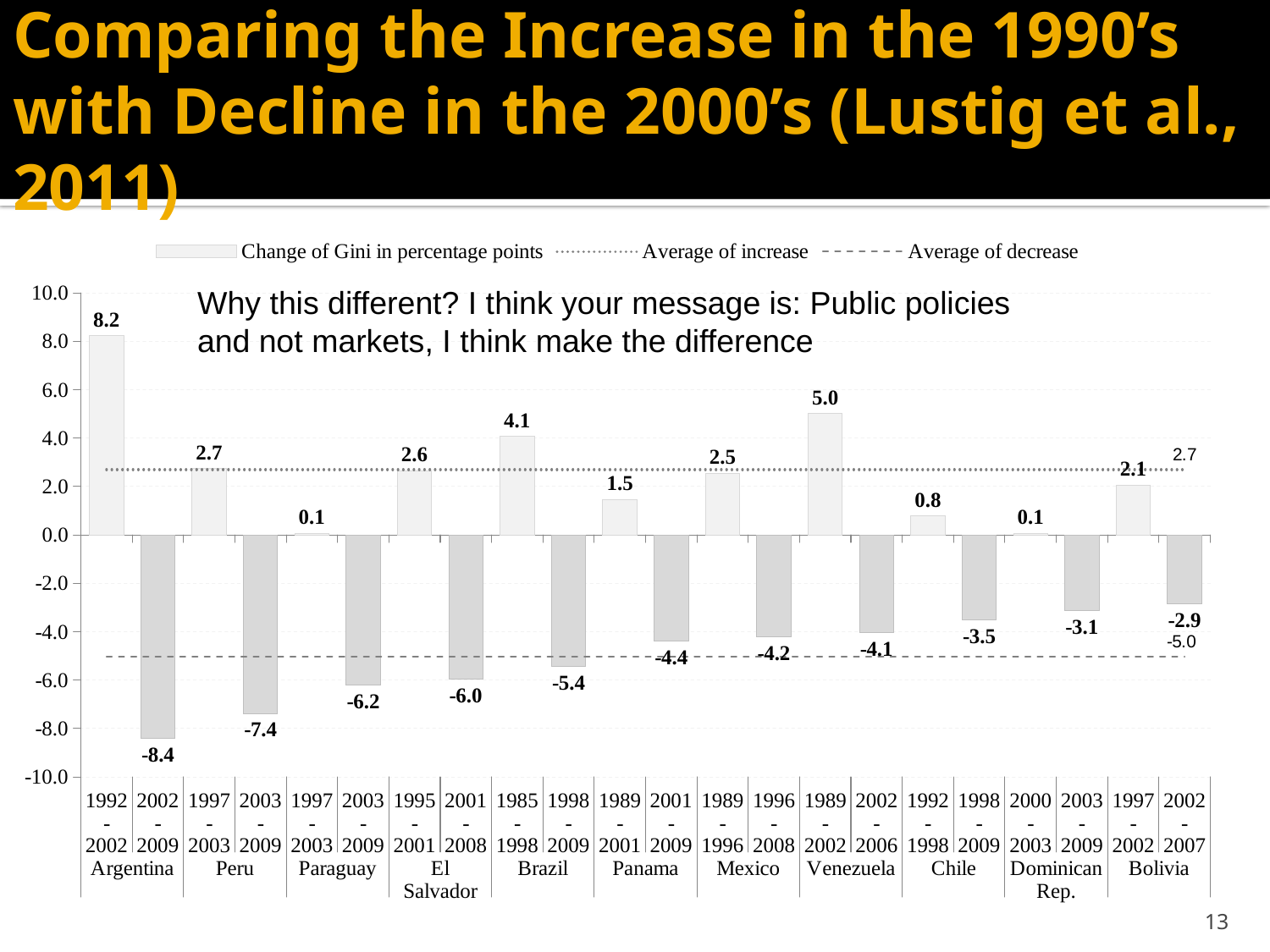
Which country-period bar has the highest change of Gini? Argentina 1992-2002 What is the difference between Brazil's 1985-1998 value and Mexico's 1989-1996 value? 1.6 How many entries does the legend list? 3 What kind of chart is shown on the slide? Bar chart How many countries are shown on the x axis? 11 What value does the 'Average of increase' line show? 2.7 What is the change of Gini in percentage points for Venezuela in 1989-2002? 5.0 Which country-period bar has the lowest change of Gini? Argentina 2002-2009 What is the change of Gini in percentage points for Peru in 2003-2009? -7.4 Which is larger: the increase for El Salvador in 1995-2001 or the increase for Bolivia in 1997-2002? El Salvador 1995-2001 What value does the 'Average of decrease' line show? -5.0 What is the change of Gini in percentage points for Argentina in 1992-2002? 8.2